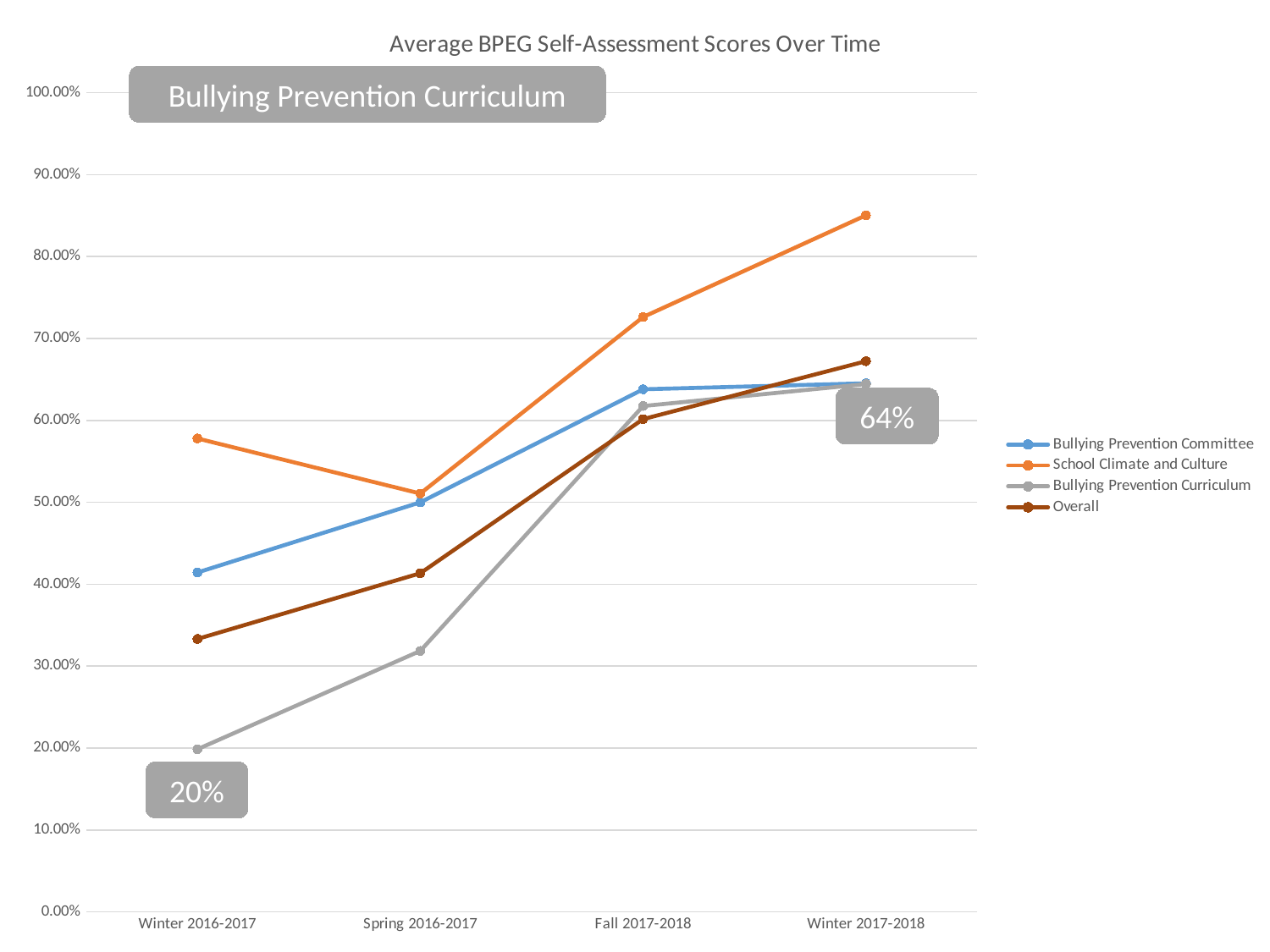
Does the School Climate and Culture line rise or fall between Winter 2016-2017 and Spring 2016-2017? fall How many series does the legend list? 4 Which series has the highest value at Winter 2017-2018? School Climate and Culture Is the School Climate and Culture value at Winter 2017-2018 greater or less than 80.00%? greater What kind of chart is shown on the slide? line chart Which series has the lowest value at Winter 2016-2017? Bullying Prevention Curriculum What is the Bullying Prevention Curriculum score at Winter 2017-2018, as labelled on the slide? 64% By how many percentage points did the Bullying Prevention Curriculum score increase from Winter 2016-2017 to Winter 2017-2018, using the labelled values? 44% Is the Overall value at Winter 2016-2017 greater or less than 40.00%? less At Spring 2016-2017, which is larger: Bullying Prevention Committee or Overall? Bullying Prevention Committee How many time points are shown on the x axis? 4 What is the Bullying Prevention Curriculum score at Winter 2016-2017, as labelled on the slide? 20%